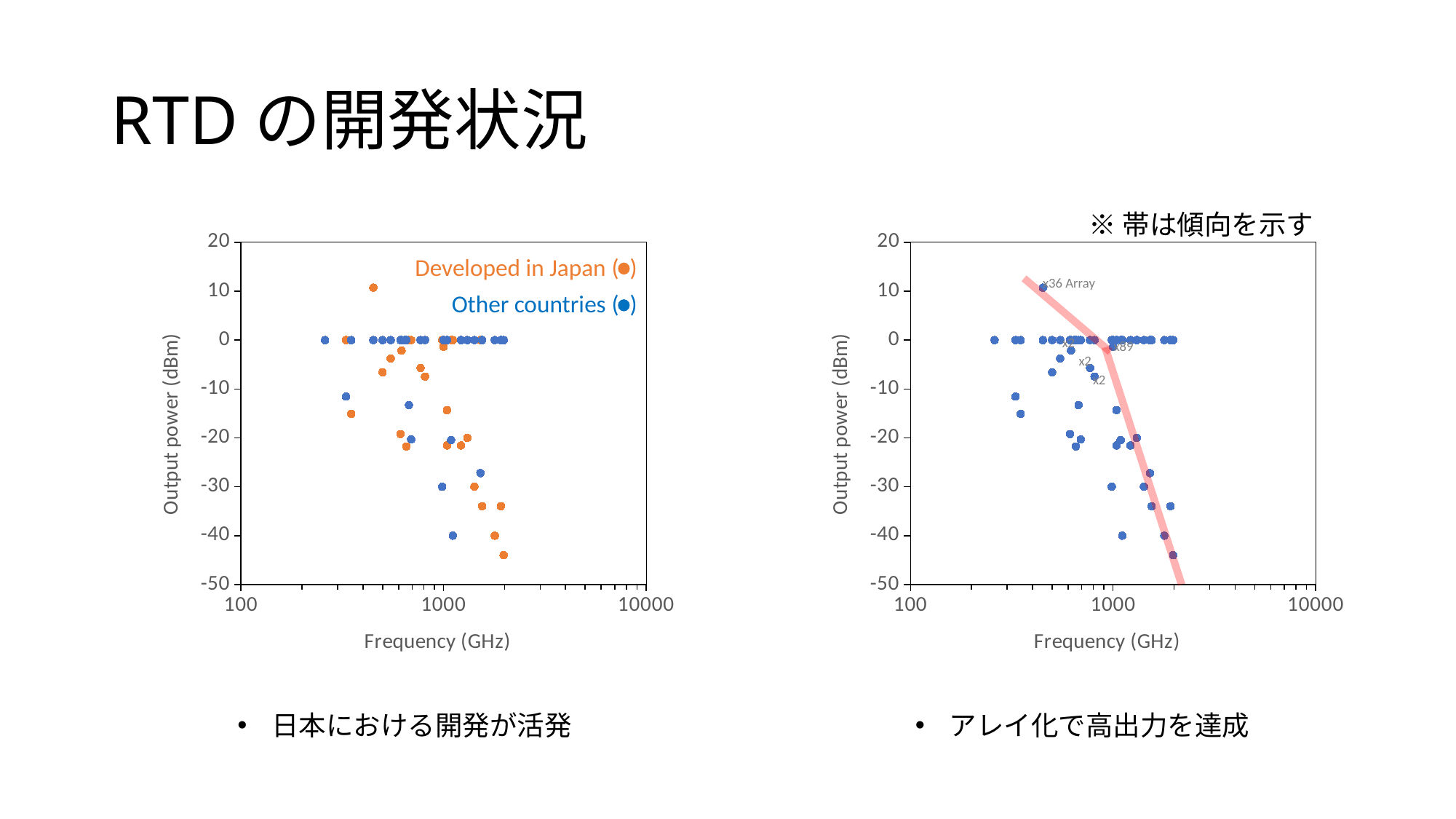
In the left chart, is the lowest plotted output power greater or less than -40 dBm? less In the left chart, which series contains the point with the highest output power? Developed in Japan In the left chart, which series contains the point with the lowest output power? Developed in Japan What is the y-axis label of the right chart? Output power (dBm) What is the highest value shown on the y-axis of the right chart? 20 What kind of chart is the left chart on the slide? Scatter chart What is the x-axis label of the left chart? Frequency (GHz) How many series does the legend of the left chart list? 2 In the right chart, what annotation labels the point with the highest output power? x36 Array In the right chart, does the pink trend band show output power rising or falling as frequency increases? falling In the left chart, which series is plotted in blue? Other countries In the left chart, which series is plotted in orange? Developed in Japan